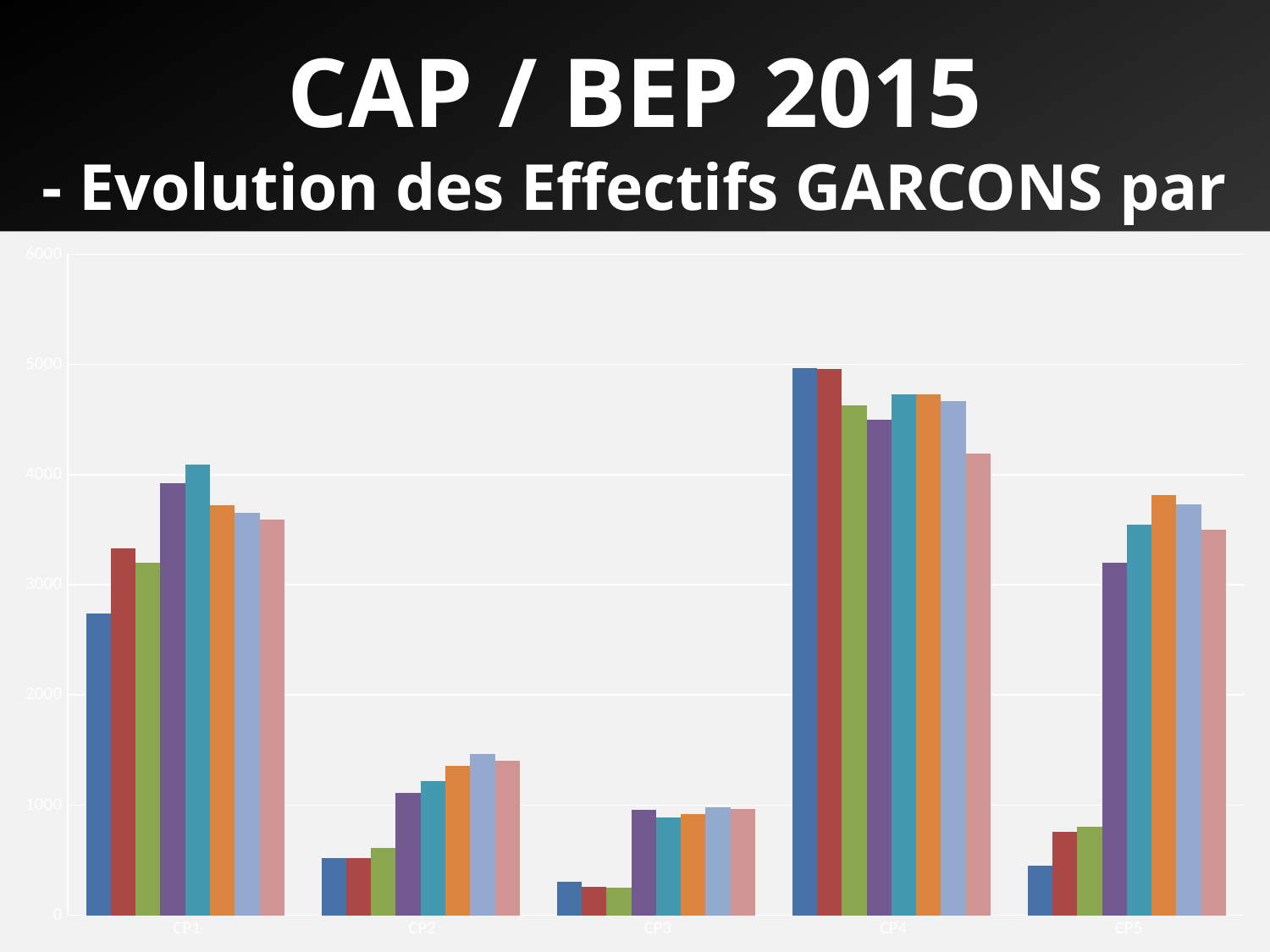
Which category has the larger first (blue) bar, CP1 or CP4? CP4 Which category has the tallest bars in the chart? CP4 Which category has the shortest bars in the chart? CP3 What kind of chart is shown on the slide? bar chart Is the value of the first (blue) bar for CP4 greater or less than 4000? greater How many bars are plotted for each category in the chart? 8 How many categories are shown on the x axis of the chart? 5 Is the value of the orange bar for CP5 greater or less than 3000? greater Within the CP5 group, do the bars generally rise or fall from left to right? rise What is the highest value shown on the vertical axis of the chart? 6000 Is the value of the first (blue) bar for CP3 greater or less than 1000? less